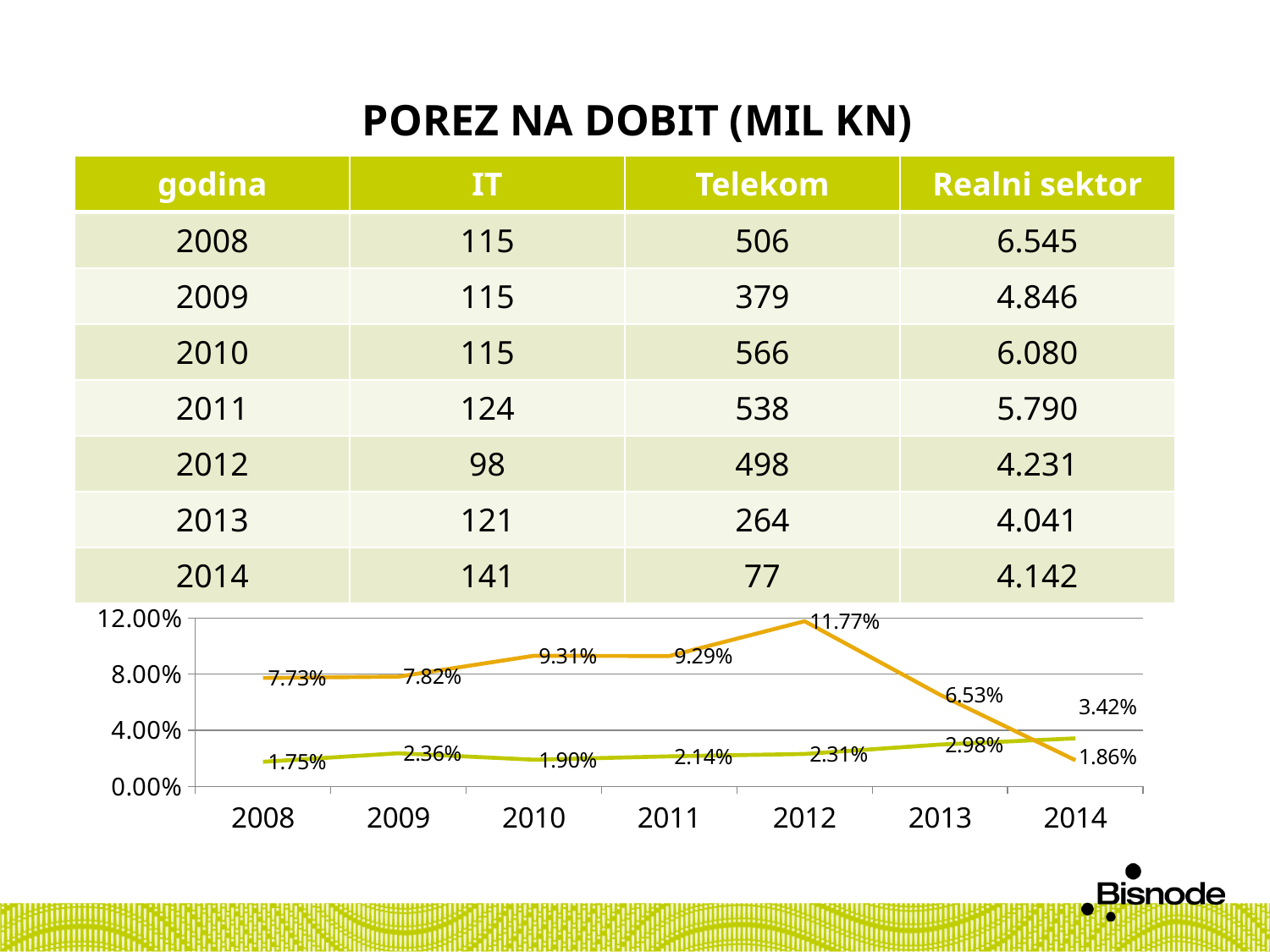
How many years are plotted along the x axis of the line chart? 7 What kind of chart is shown below the table on the slide? line chart In the line chart, what is the value of the orange line for 2008? 7.73% In the line chart, what is the value of the green line for 2010? 1.90% In the line chart, in which year does the green line have its lowest value? 2008 In the line chart, what is the value of the green line for 2014? 3.42% In the line chart, which is larger for 2014: the orange line or the green line? the green line In the line chart, in which year does the orange line reach its highest value? 2012 In the line chart, what is the difference between the orange line's value in 2012 and its value in 2013? 5.24% In the line chart, does the green line generally rise or fall from 2008 to 2014? rise In the line chart, what is the value of the orange line for 2012? 11.77% In the line chart, is the orange line's value for 2013 greater or less than 8.00%? less